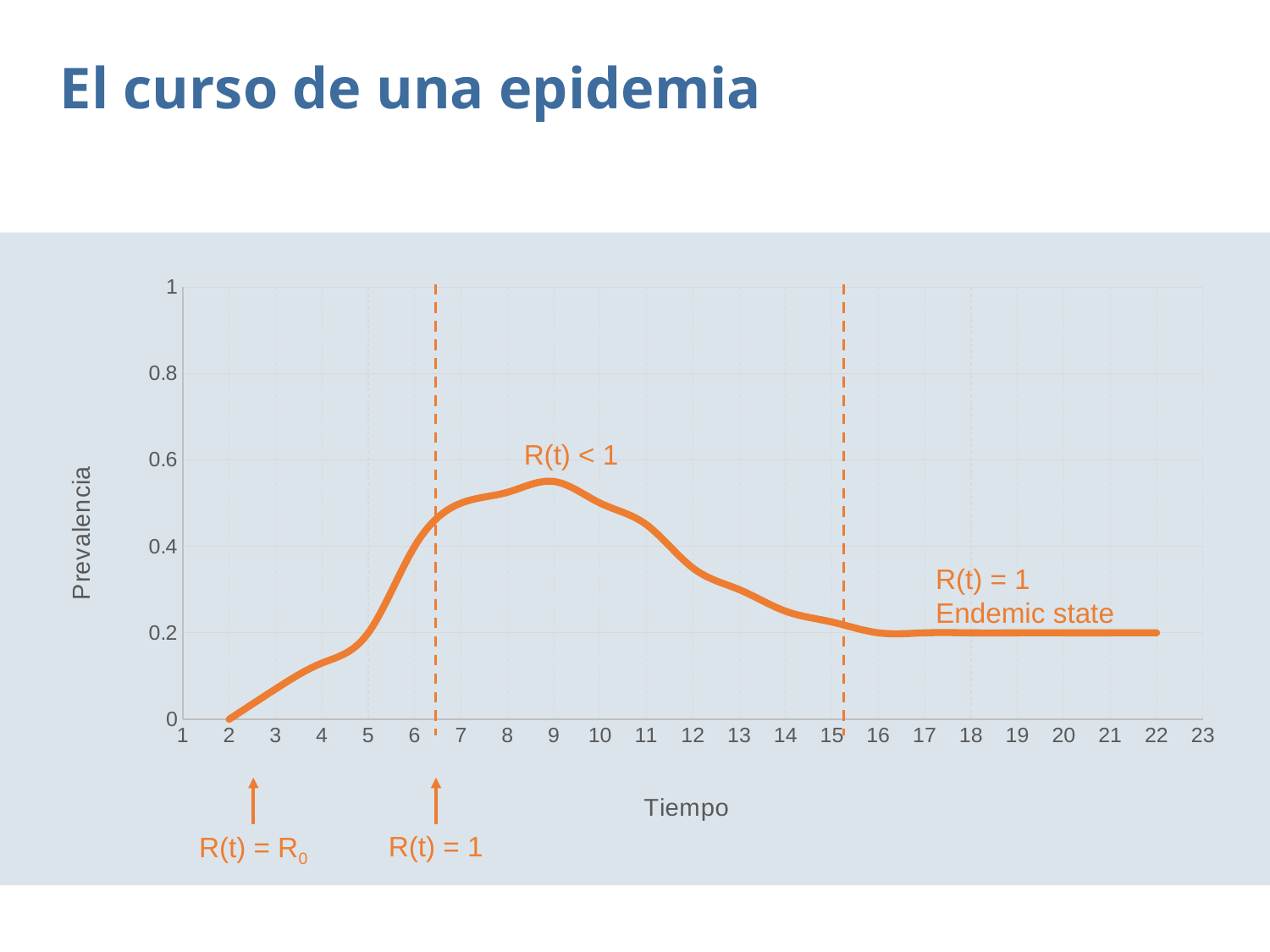
What is the prevalence value at time 20? 0.2 Is the prevalence at time 4 greater or less than 0.2? less Which has the higher prevalence, time 7 or time 13? time 7 Does the prevalence rise or fall between time 2 and time 9? rise Is the prevalence at time 9 greater or less than 0.6? less What is the label of the y axis of the chart? Prevalencia What kind of chart is shown on the slide? line chart Is the prevalence at time 9 greater or less than 0.4? greater What is the label of the x axis of the chart? Tiempo At which time value does the prevalence curve reach its highest point? 9